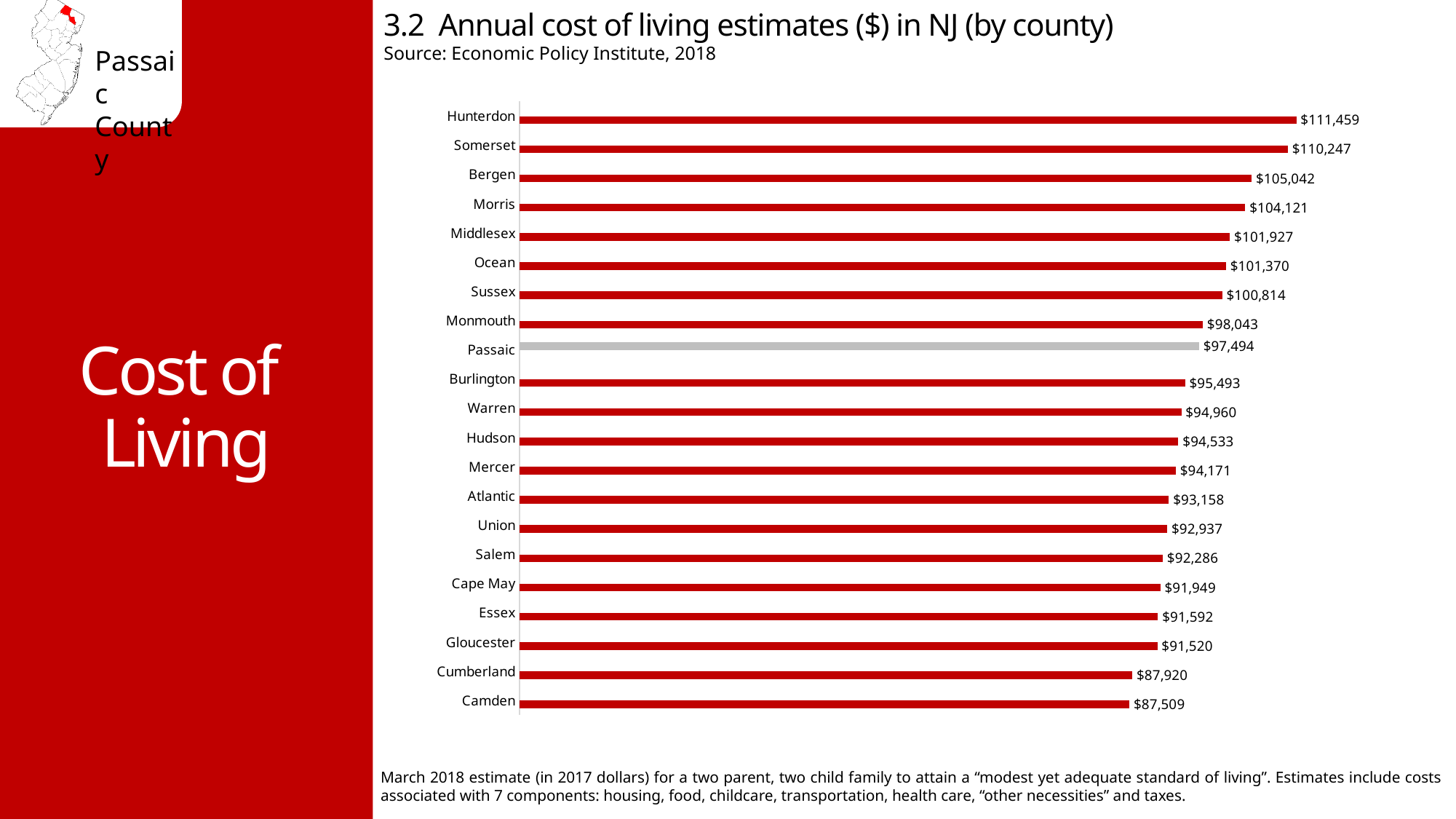
What is the annual cost of living estimate for Bergen County? $105,042 How many counties are shown in the chart? 21 What is the annual cost of living estimate for Passaic County? $97,494 What is the annual cost of living estimate for Cumberland County? $87,920 Which county has a higher cost of living estimate, Morris or Ocean? Morris What is the difference between the cost of living estimates for Hunterdon and Camden? $23,950 Which county has the highest annual cost of living estimate? Hunterdon What type of chart is used on this slide? Bar chart What is the difference between the cost of living estimates for Monmouth and Passaic? $549 Which county has the lowest annual cost of living estimate? Camden Which county's bar is shown in grey instead of red? Passaic What is the source cited for the chart? Economic Policy Institute, 2018